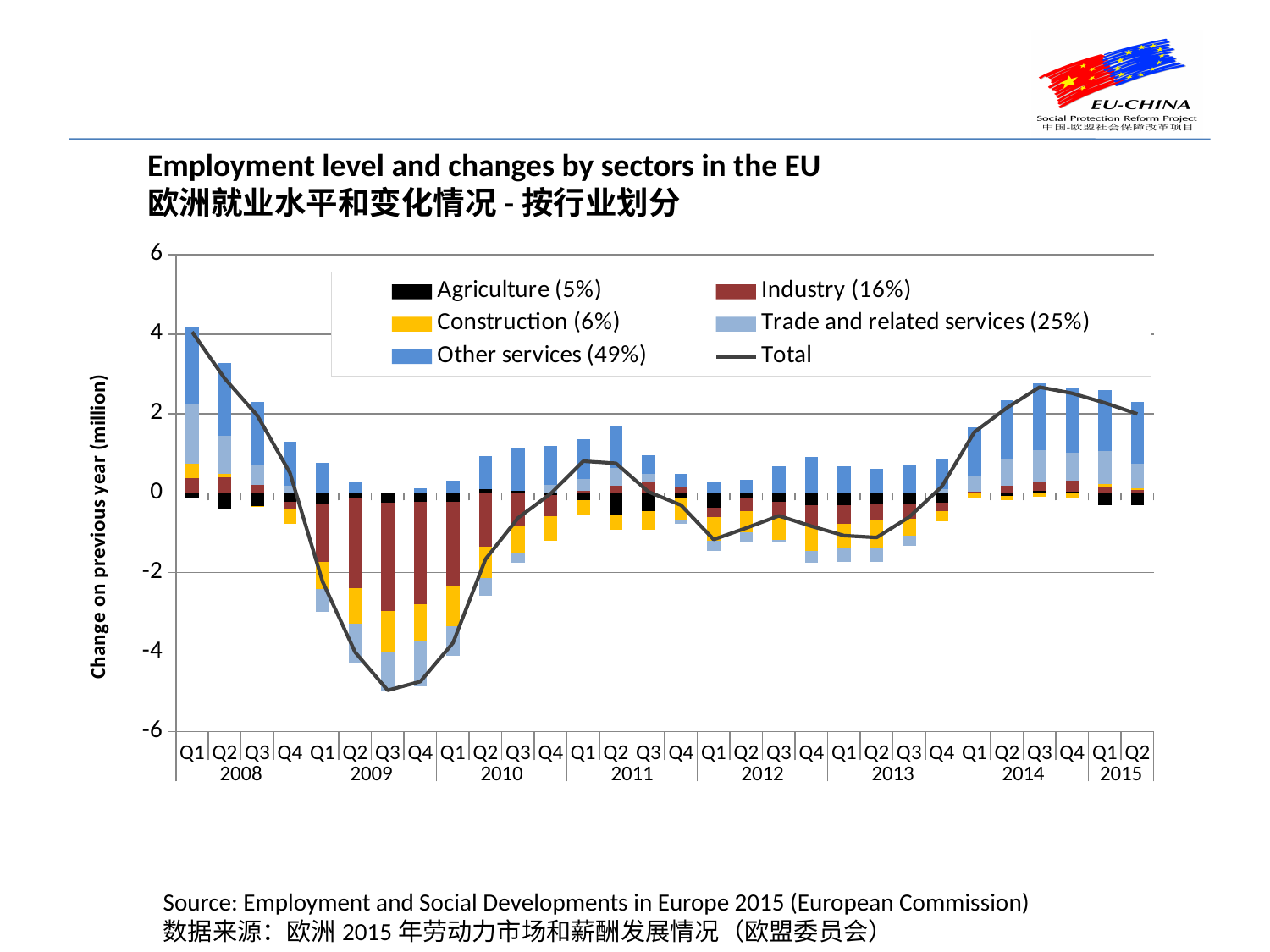
Is the Total value for Q1 2012 greater or less than 0? less How many series does the legend list? 6 Is the Total value for Q3 2009 greater or less than -4? less Does the Total line rise or fall from Q1 2008 to Q3 2009? fall What is the label on the y axis? Change on previous year (million) How many quarters are plotted along the x axis? 30 In which quarter does the Total line reach its lowest point? Q3 2009 What percentage is shown in the legend next to Other services? 49% Is the Total value for Q1 2008 greater or less than 2? greater In which quarter does the Total line reach its highest point? Q1 2008 Which is larger, the Total value for Q1 2008 or for Q1 2009? Q1 2008 What kind of chart is shown on the slide? Stacked bar chart with a line